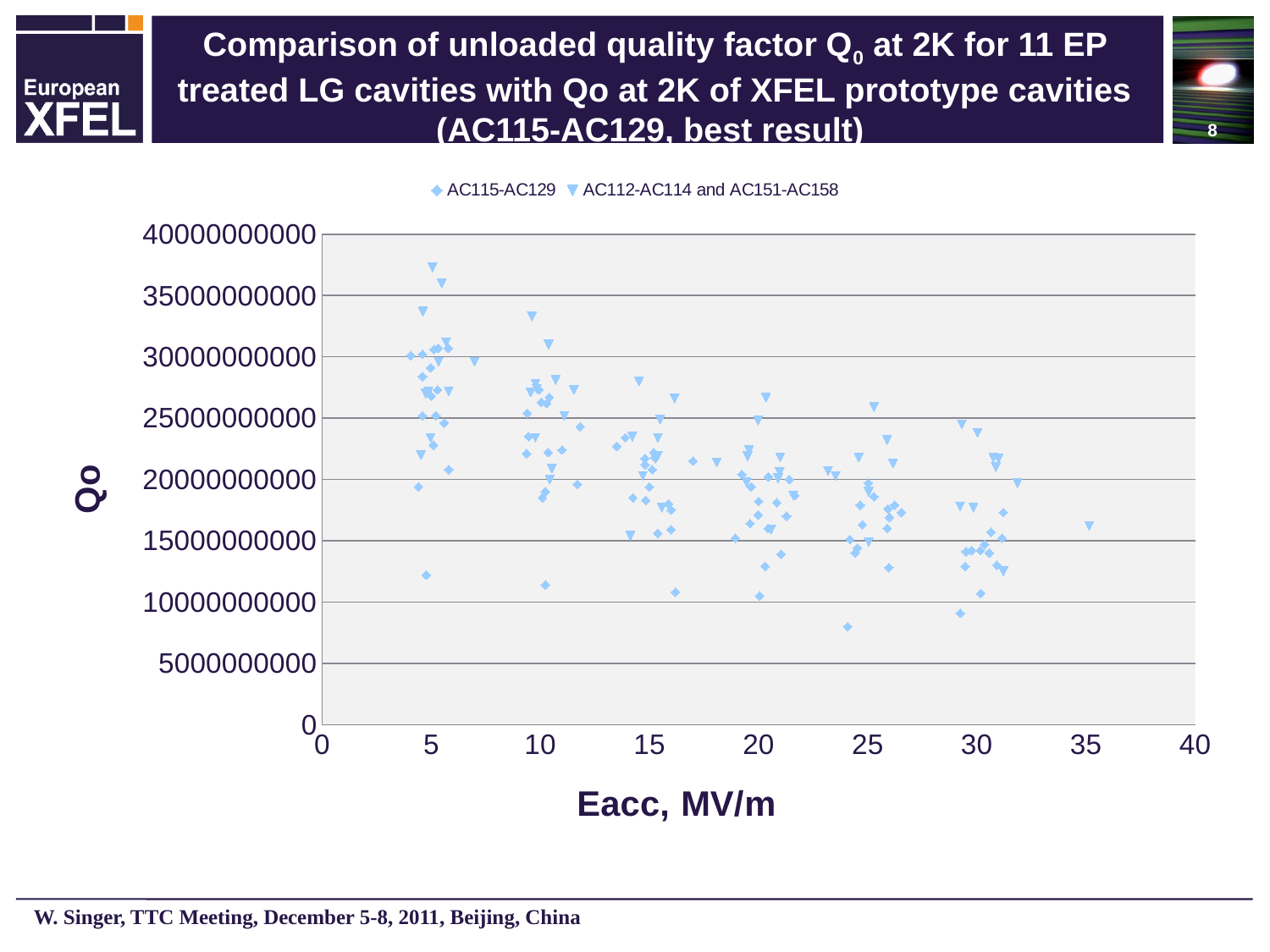
Is the lowest Qo value plotted greater or less than 10000000000? less What are the two series named in the legend? AC115-AC129; AC112-AC114 and AC151-AC158 How many series does the legend list? 2 Is the highest Qo value plotted greater or less than 35000000000? greater What is the maximum value shown on the y axis? 40000000000 What kind of chart is shown on the slide? scatter chart Is the Qo value of the point plotted at about 35 MV/m greater or less than 15000000000? greater What is the label of the x axis? Eacc, MV/m Which series contains the point with the highest Qo value, AC115-AC129 or AC112-AC114 and AC151-AC158? AC112-AC114 and AC151-AC158 Do the Qo values generally rise or fall as Eacc increases? fall